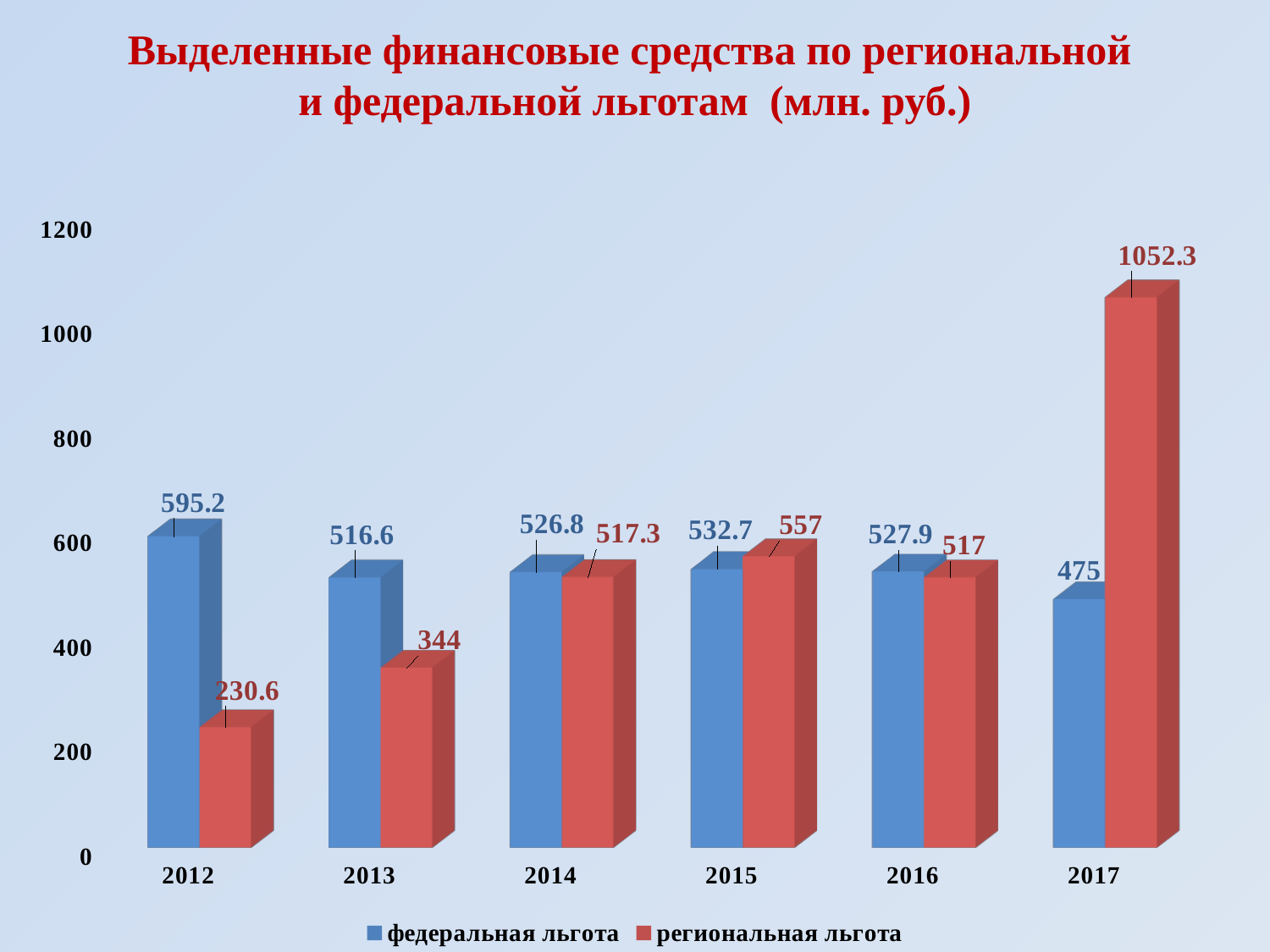
In which year is the федеральная льгота value the lowest? 2017 What is the value for федеральная льгота in 2012? 595.2 What is the value for региональная льгота in 2017? 1052.3 What is the value for региональная льгота in 2013? 344 What kind of chart is shown on the slide? bar chart How many years are shown on the x axis? 6 Which is larger in 2015, федеральная льгота or региональная льгота? региональная льгота Does the региональная льгота value rise or fall from 2012 to 2017? rise In which year is the региональная льгота value the lowest? 2012 How many series does the legend list? 2 In which year is the региональная льгота value the highest? 2017 What is the difference between региональная льгота and федеральная льгота in 2017? 577.3